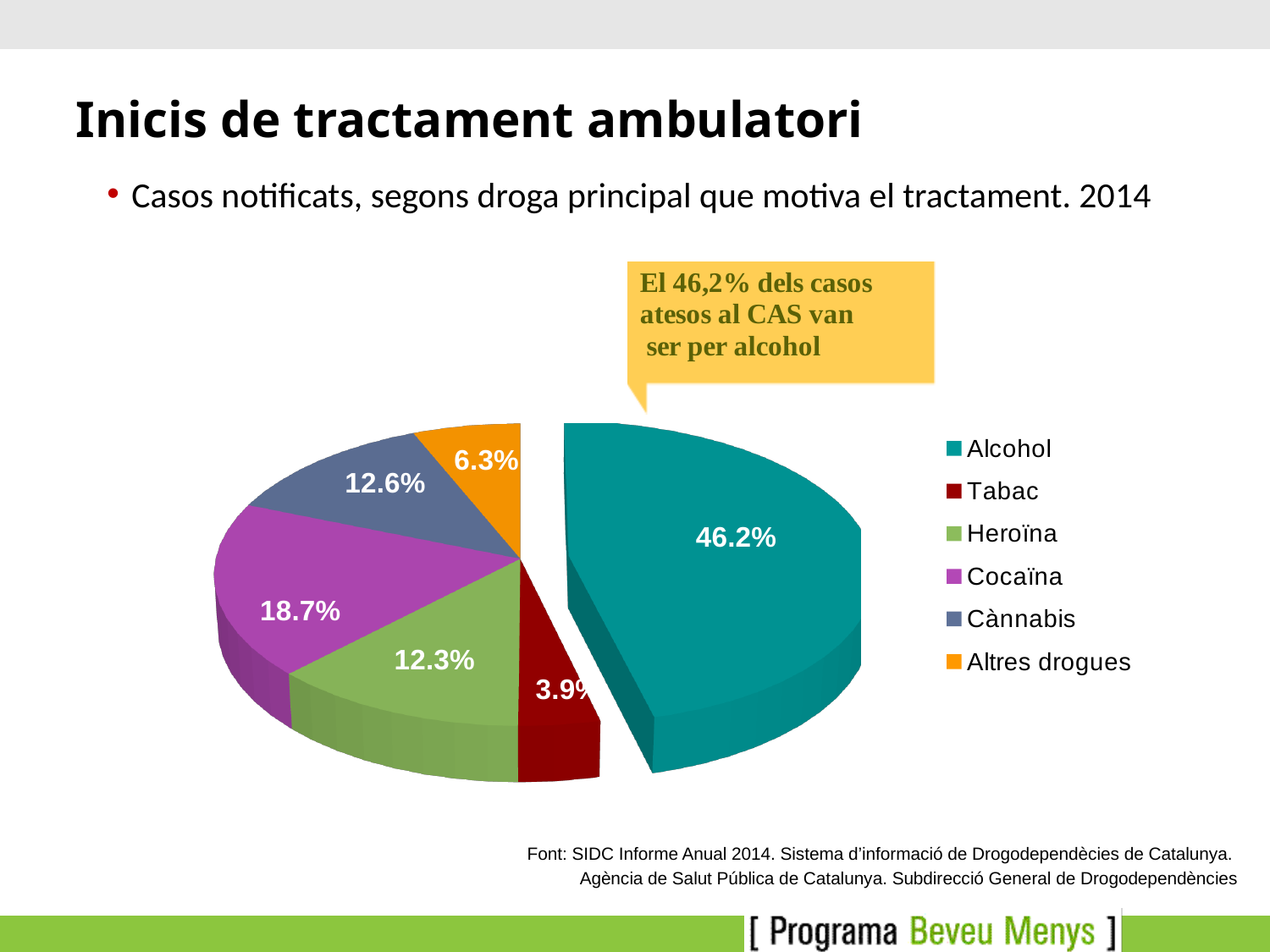
What kind of chart is shown on the slide? Pie chart How many categories does the pie chart show? 6 Which category has the smallest slice of the pie? Tabac What percentage is shown for Tabac? 3.9% Which category is shown in orange in the legend? Altres drogues Which is larger, the share for Cocaïna or the share for Heroïna? Cocaïna What percentage is shown for Cocaïna? 18.7% What is the difference in percentage points between Cocaïna and Altres drogues? 12.4 Which category has the largest slice of the pie? Alcohol What percentage is shown for Altres drogues? 6.3% What share of the pie does Alcohol represent? 46.2% What is the difference in percentage points between Alcohol and Cocaïna? 27.5